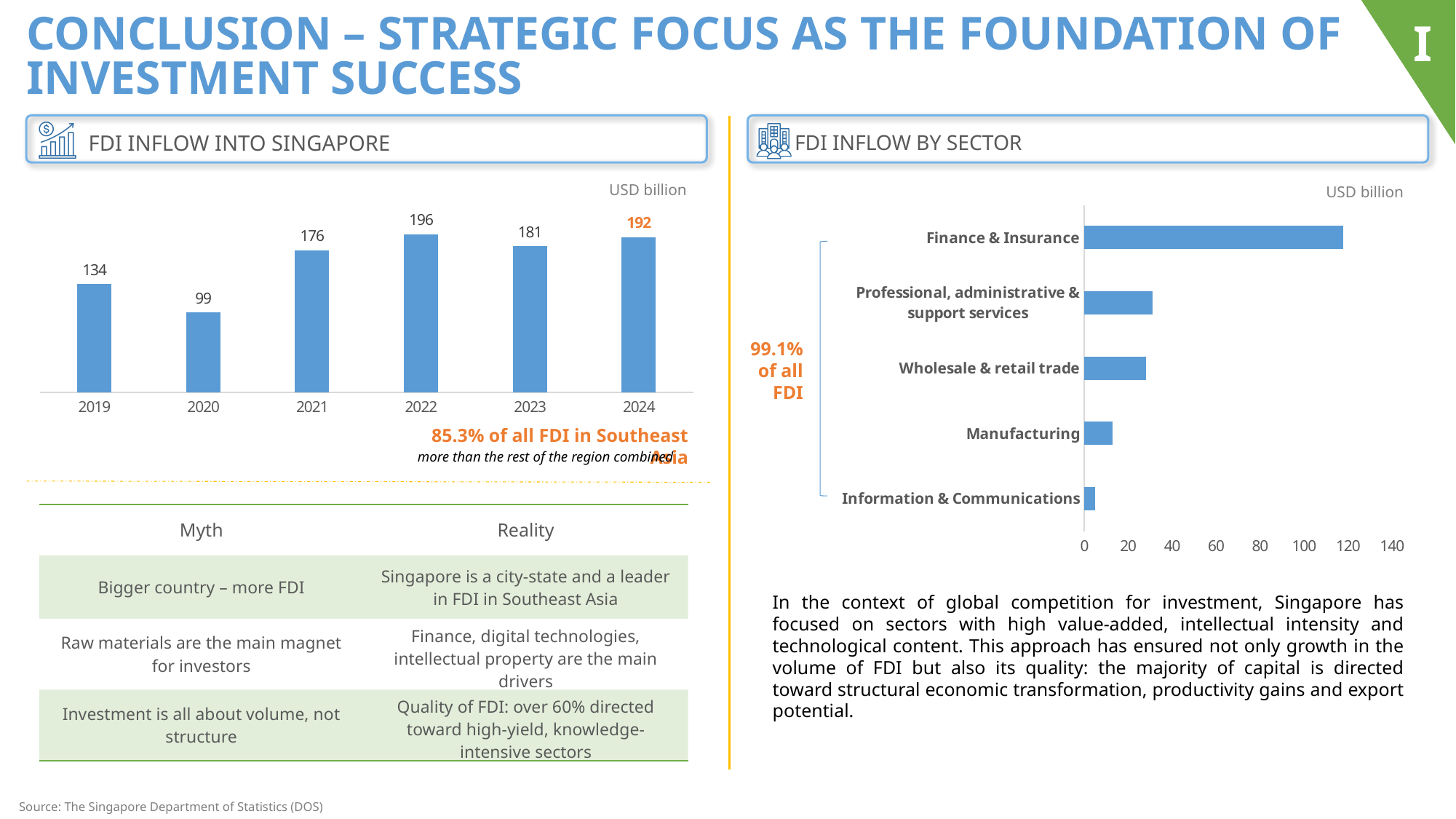
In the FDI INFLOW INTO SINGAPORE chart, what is the value for 2022? 196 In the FDI INFLOW INTO SINGAPORE chart, which year has the lowest value? 2020 What kind of chart is the FDI INFLOW BY SECTOR chart? Bar chart How many years are shown in the FDI INFLOW INTO SINGAPORE chart? 6 In the FDI INFLOW INTO SINGAPORE chart, which year has the highest value? 2022 In the FDI INFLOW INTO SINGAPORE chart, what is the difference between the 2024 and 2023 values? 11 In the FDI INFLOW BY SECTOR chart, which sector has the lowest value? Information & Communications In the FDI INFLOW BY SECTOR chart, which sector has the highest value? Finance & Insurance In the FDI INFLOW INTO SINGAPORE chart, which is larger, the value for 2021 or the value for 2019? 2021 In the FDI INFLOW INTO SINGAPORE chart, what is the value for 2020? 99 In the FDI INFLOW BY SECTOR chart, is the value for Finance & Insurance greater or less than 100? greater In the FDI INFLOW BY SECTOR chart, is the value for Manufacturing greater or less than 20? less